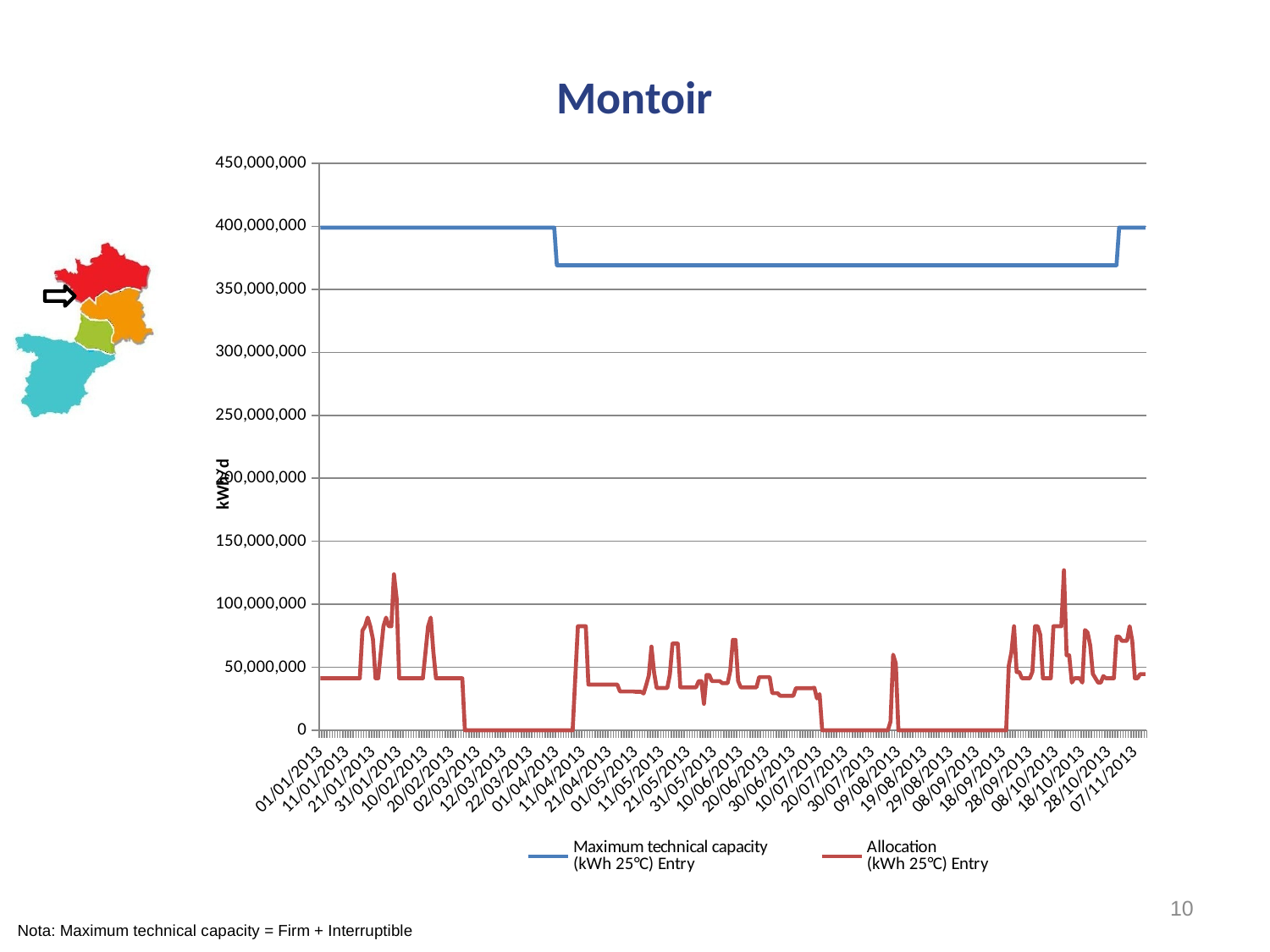
Around the end of October 2013, does the Maximum technical capacity (kWh 25°C) Entry line rise or fall? rise Is the Maximum technical capacity (kWh 25°C) Entry value on 20/06/2013 greater or less than 400,000,000? less What kind of chart is shown on the slide? line chart Which series has the higher values across the whole chart, Maximum technical capacity (kWh 25°C) Entry or Allocation (kWh 25°C) Entry? Maximum technical capacity (kWh 25°C) Entry Is the Maximum technical capacity (kWh 25°C) Entry value on 01/01/2013 greater or less than 350,000,000? greater Is the Allocation (kWh 25°C) Entry value on 01/01/2013 greater or less than 100,000,000? less How many series does the chart legend list? 2 What is the label on the vertical axis of the chart? kWh/d What is the title of the chart? Montoir Around the start of April 2013, does the Maximum technical capacity (kWh 25°C) Entry line rise or fall? fall